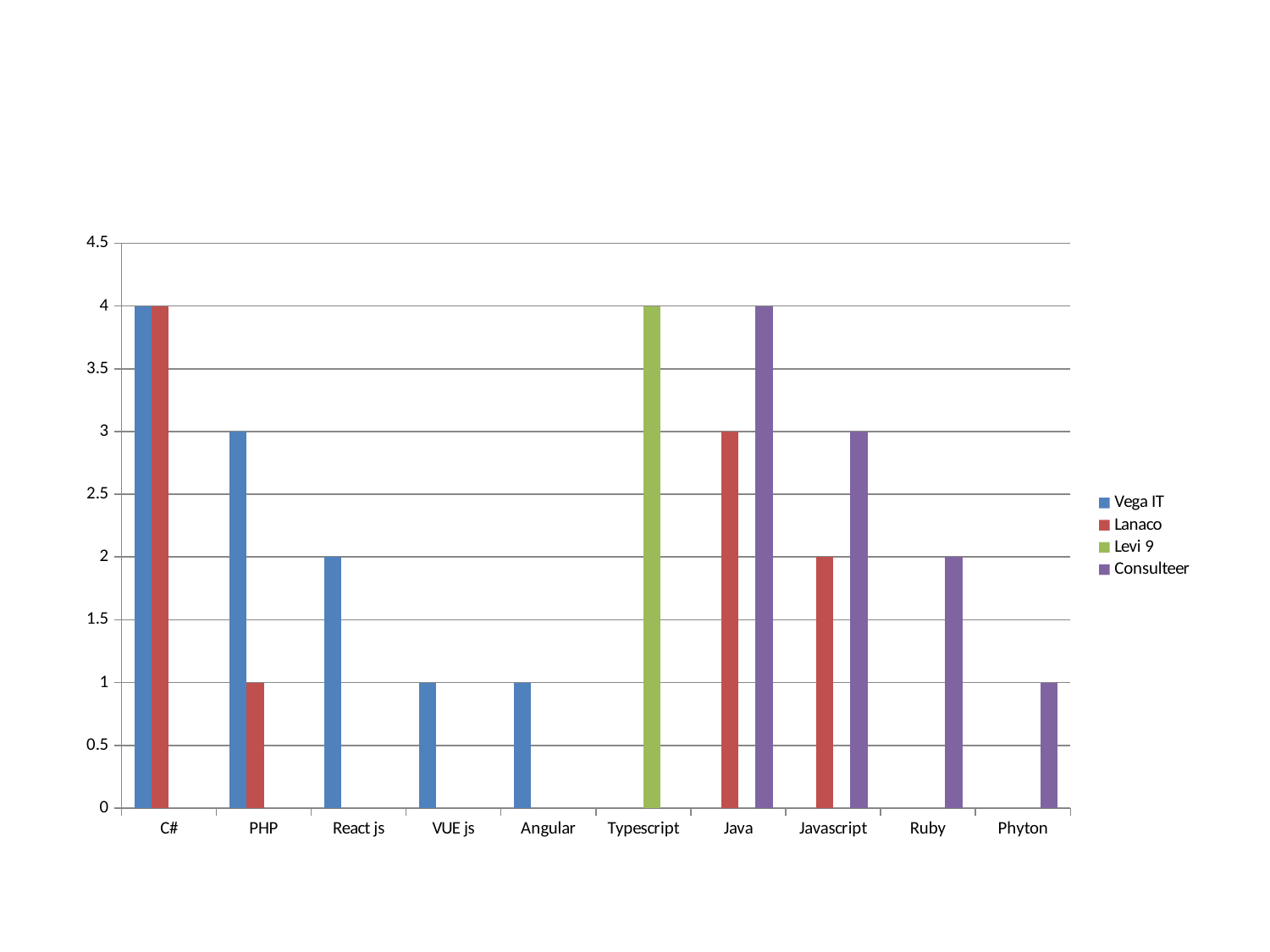
How many series does the legend list? 4 What is the value for Lanaco in the PHP category? 1 How many categories are shown on the x axis? 10 Which category has the lowest value for Consulteer? Phyton What is the value for Consulteer in the Ruby category? 2 What is the difference between the Consulteer value and the Lanaco value in the Java category? 1 Which series is shown in green in the legend? Levi 9 What is the value for Levi 9 in the Typescript category? 4 What is the value for Vega IT in the C# category? 4 What type of chart is shown on the slide? bar chart In the Javascript category, which is larger: the Lanaco value or the Consulteer value? Consulteer Which category has the highest value for Vega IT? C#